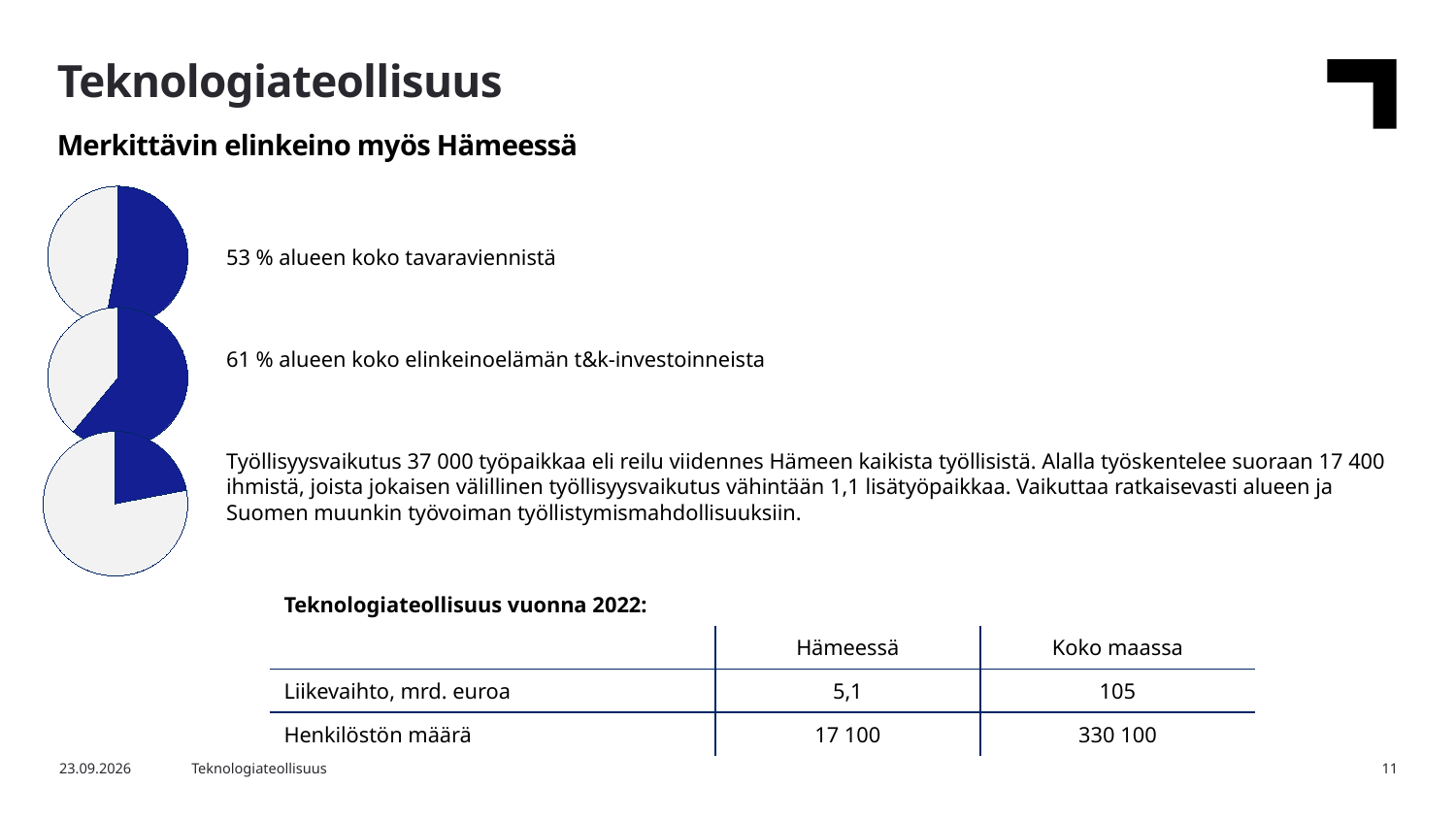
Which of the three pie charts has the largest blue slice? The middle one (t&k-investoinnit) What share of the top pie chart is the grey (non-highlighted) portion? 47 % Is the blue slice of the bottom pie chart more or less than half of the pie? Less By how many percentage points does the blue share in the middle pie chart (61 %) exceed the blue share in the top pie chart (53 %)? 8 percentage points How many pie charts are shown on the slide? 3 According to the text beside the middle pie chart, what share of the region's business R&D investments (t&k-investoinnit) does the blue slice represent? 61 % Which pie chart has the larger blue slice, the top one (tavaravienti) or the middle one (t&k-investoinnit)? The middle one (t&k-investoinnit) According to the text beside the top pie chart, what share of the region's total goods exports (tavaravienti) does the blue slice represent? 53 % What kind of chart is shown at the top left of the slide? Pie chart Is the blue slice of the middle pie chart more or less than half of the pie? More What colour is the highlighted slice in each of the pie charts? Dark blue Which of the three pie charts has the smallest blue slice? The bottom one (työllisyysvaikutus)